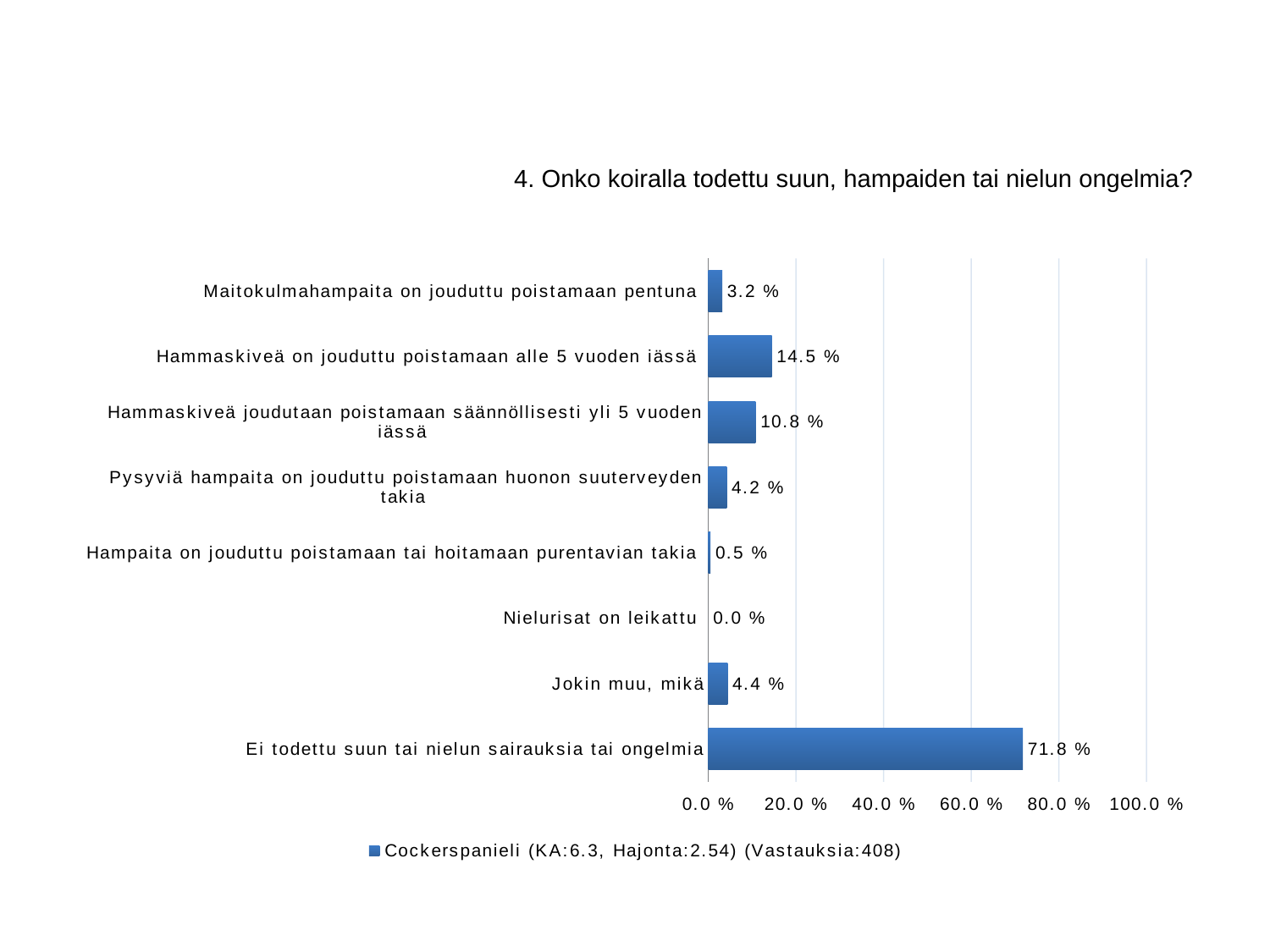
What kind of chart is shown on the slide? bar chart What is the title of the chart? 4. Onko koiralla todettu suun, hampaiden tai nielun ongelmia? How many series does the legend list? 1 What is the value for "Ei todettu suun tai nielun sairauksia tai ongelmia"? 71.8 % Is the value for "Ei todettu suun tai nielun sairauksia tai ongelmia" greater or less than 60.0 %? greater What is the difference between the values for "Hammaskiveä on jouduttu poistamaan alle 5 vuoden iässä" and "Hammaskiveä joudutaan poistamaan säännöllisesti yli 5 vuoden iässä"? 3.7 % Which category has the highest value? Ei todettu suun tai nielun sairauksia tai ongelmia Which category has the lowest value? Nielurisat on leikattu What is the value for "Hammaskiveä on jouduttu poistamaan alle 5 vuoden iässä"? 14.5 % Which is larger: the value for "Jokin muu, mikä" or the value for "Pysyviä hampaita on jouduttu poistamaan huonon suuterveyden takia"? Jokin muu, mikä What is the value for "Nielurisat on leikattu"? 0.0 % How many categories are shown in the chart? 8